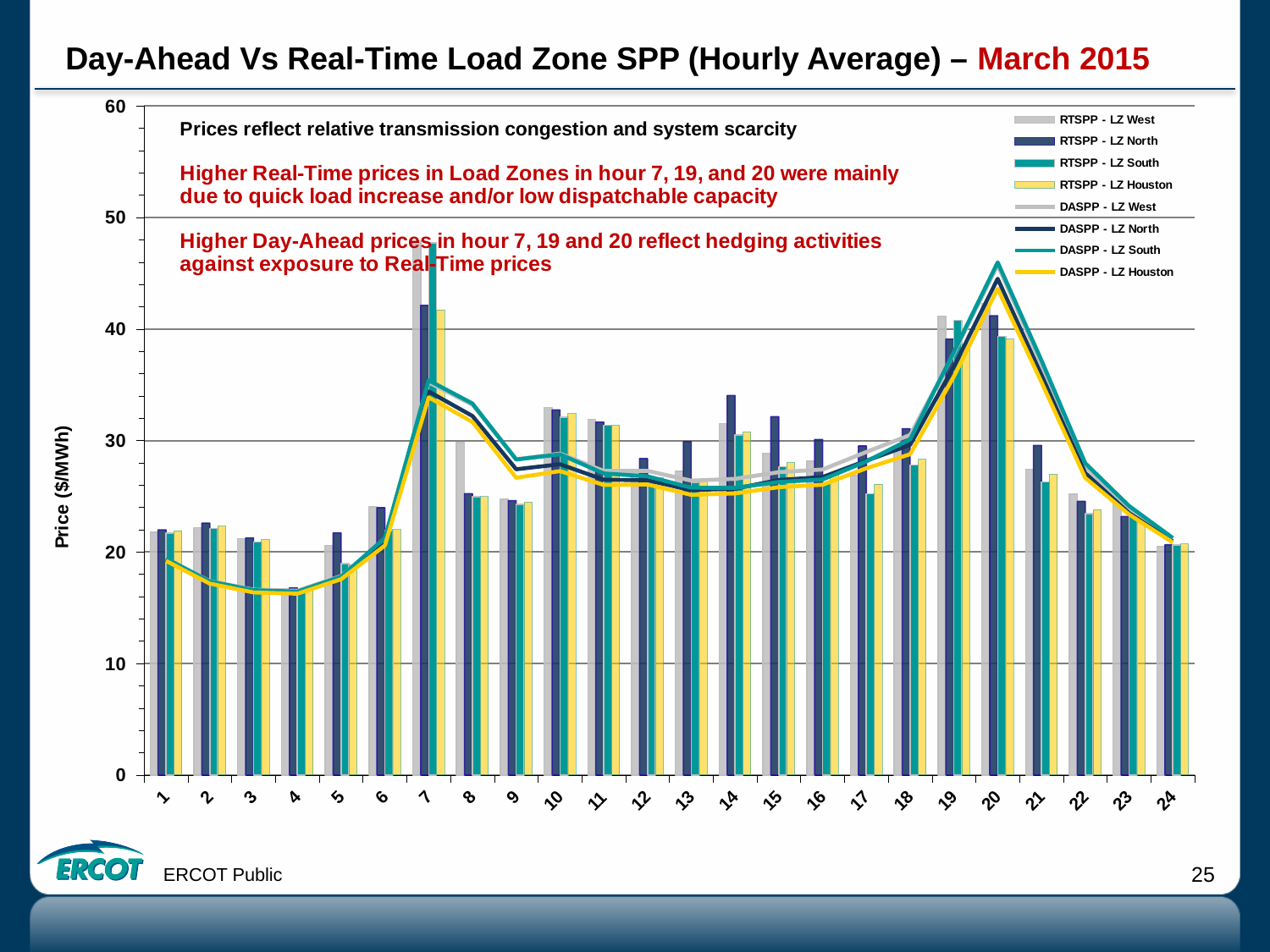
At which hour is the RTSPP - LZ West bar lowest? 4 At which hour do the DASPP lines reach their peak? 20 What kind of chart is this? Combined bar and line chart Is the RTSPP - LZ West value at hour 7 greater or less than 40? greater How many series does the legend list? 8 Is the DASPP - LZ Houston value at hour 20 greater or less than 40? greater Which is larger, the RTSPP - LZ West value at hour 7 or at hour 19? Hour 7 Is the RTSPP - LZ North value at hour 4 greater or less than 20? less How many hours are shown along the x axis? 24 At which hour is the RTSPP - LZ West bar highest? 7 What is the label on the y axis? Price ($/MWh) Do the DASPP lines rise or fall from hour 20 to hour 24? Fall